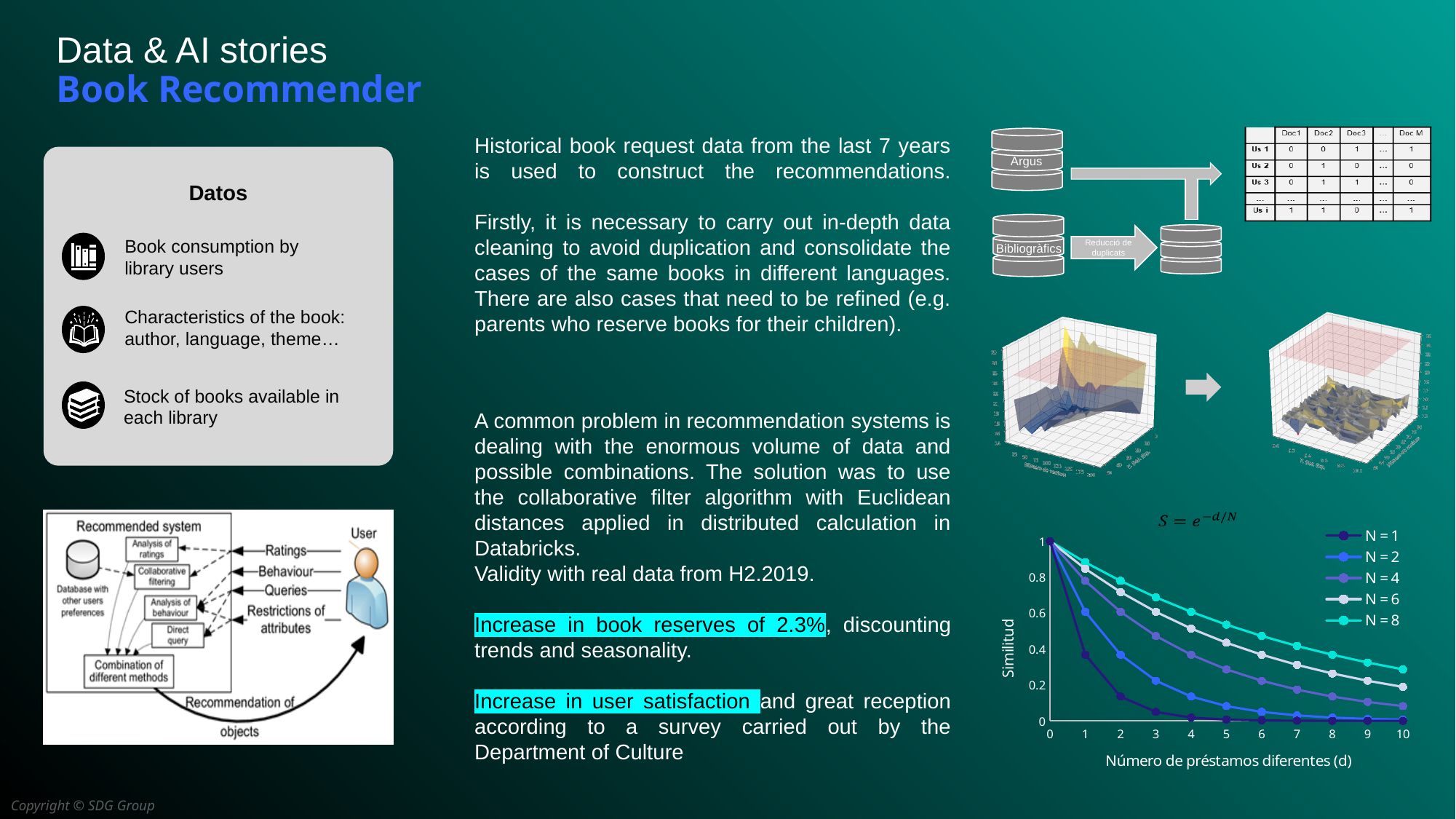
In the bottom-right line chart, is the value for N = 1 at d = 5 greater or less than 0.2? less How many series does the legend of the bottom-right line chart list? 5 What are the legend entries of the bottom-right line chart? N = 1, N = 2, N = 4, N = 6, N = 8 In the bottom-right line chart, do the values rise or fall as d increases along the x axis? fall In the bottom-right line chart, which series has the highest value at d = 10? N = 8 In the bottom-right line chart, is the value for N = 8 at d = 10 greater or less than 0.2? greater What kind of chart is shown at the bottom right of the slide? line chart In the bottom-right line chart, which series has the lowest value at d = 10? N = 1 What is the x-axis label of the bottom-right line chart? Número de préstamos diferentes (d) How many x-axis points (values of d) are plotted for each series in the bottom-right line chart? 11 In the bottom-right line chart, what is the value of every series at d = 0? 1 In the bottom-right line chart, at d = 5, which series is higher: N = 8 or N = 2? N = 8